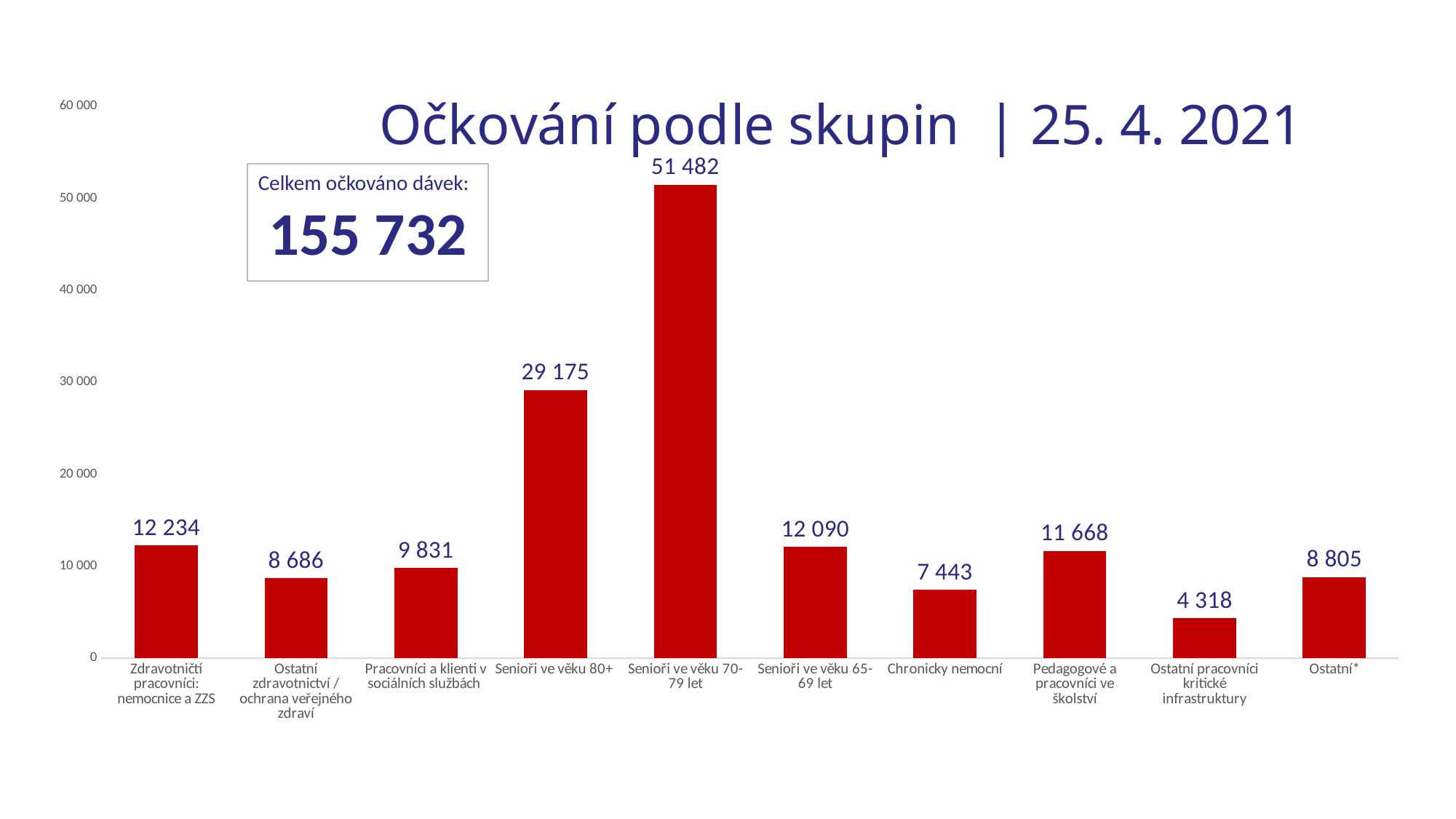
How many categories are shown on the chart? 10 What is the title of the chart? Očkování podle skupin | 25. 4. 2021 Which category has the lowest value? Ostatní pracovníci kritické infrastruktury What total number of doses (Celkem očkováno dávek) is shown in the box on the slide? 155 732 Is the value for Ostatní* greater or less than 10 000? less What is the difference between the values for Senioři ve věku 70-79 let and Senioři ve věku 80+? 22 307 Which is larger: the value for Zdravotničtí pracovníci: nemocnice a ZZS or the value for Senioři ve věku 65-69 let? Zdravotničtí pracovníci: nemocnice a ZZS What is the value for Senioři ve věku 80+? 29 175 What is the value for Pedagogové a pracovníci ve školství? 11 668 Which category has the highest value? Senioři ve věku 70-79 let What is the value for Chronicky nemocní? 7 443 What kind of chart is shown on the slide? bar chart